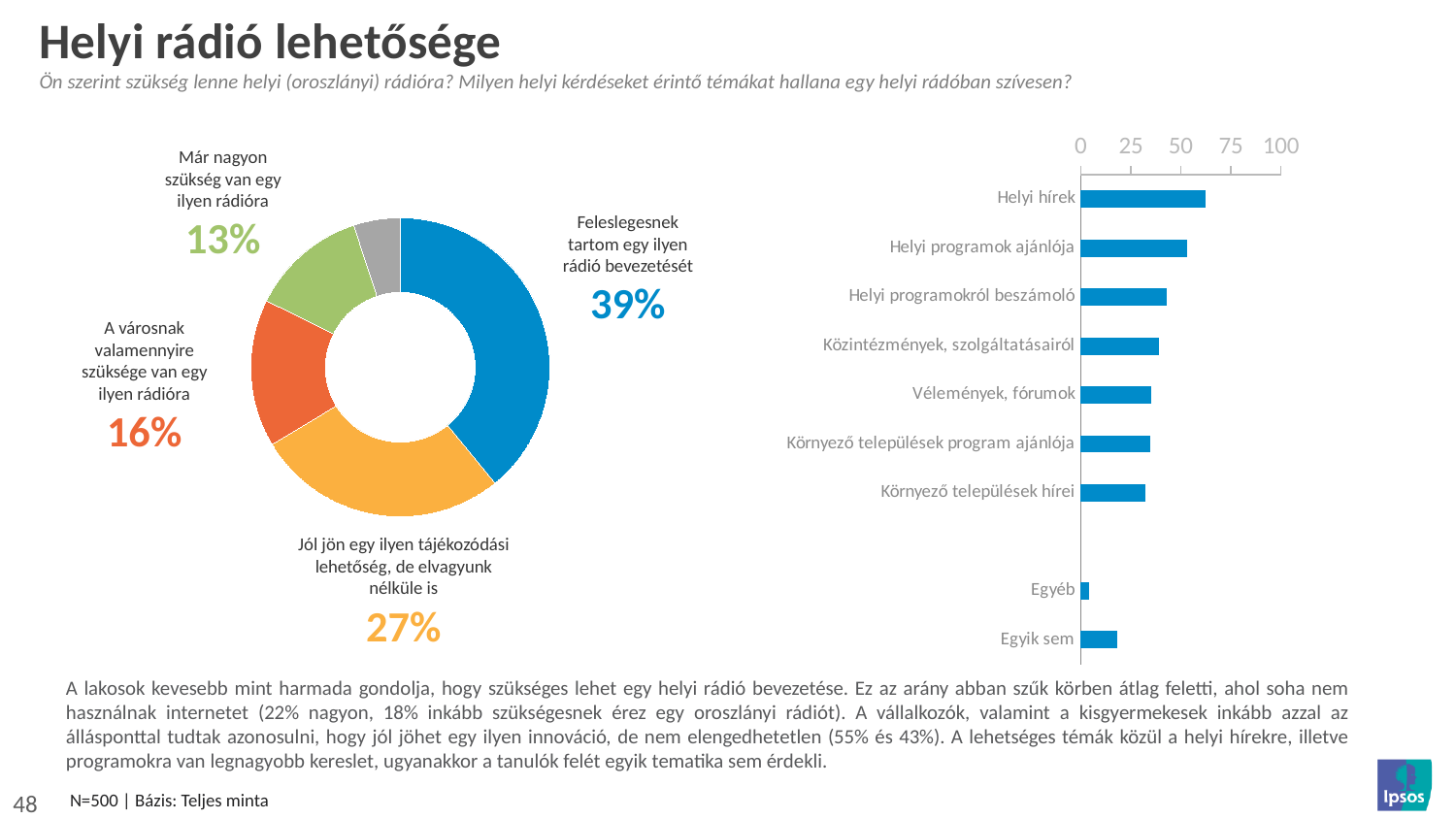
How many categories are shown on the bar chart on the right? 9 On the bar chart on the right, which topic has the highest value? Helyi hírek On the donut chart, what percentage of respondents say they consider introducing a local radio unnecessary (Feleslegesnek tartom egy ilyen rádió bevezetését)? 39% On the donut chart, what percentage chose 'Már nagyon szükség van egy ilyen rádióra'? 13% What type of chart is shown on the right side of the slide? Bar chart On the bar chart on the right, which category has the lowest value? Egyéb On the bar chart on the right, is the value for Egyik sem greater or less than 25? less On the donut chart, which labeled answer has the largest share? Feleslegesnek tartom egy ilyen rádió bevezetését On the donut chart, which is larger: 'A városnak valamennyire szüksége van egy ilyen rádióra' or 'Már nagyon szükség van egy ilyen rádióra'? A városnak valamennyire szüksége van egy ilyen rádióra On the bar chart on the right, is the value for Helyi hírek greater or less than 50? greater On the donut chart, what percentage chose 'Jól jön egy ilyen tájékozódási lehetőség, de elvagyunk nélküle is'? 27% On the donut chart, what is the difference in percentage points between 'Feleslegesnek tartom egy ilyen rádió bevezetését' and 'Jól jön egy ilyen tájékozódási lehetőség, de elvagyunk nélküle is'? 12 percentage points